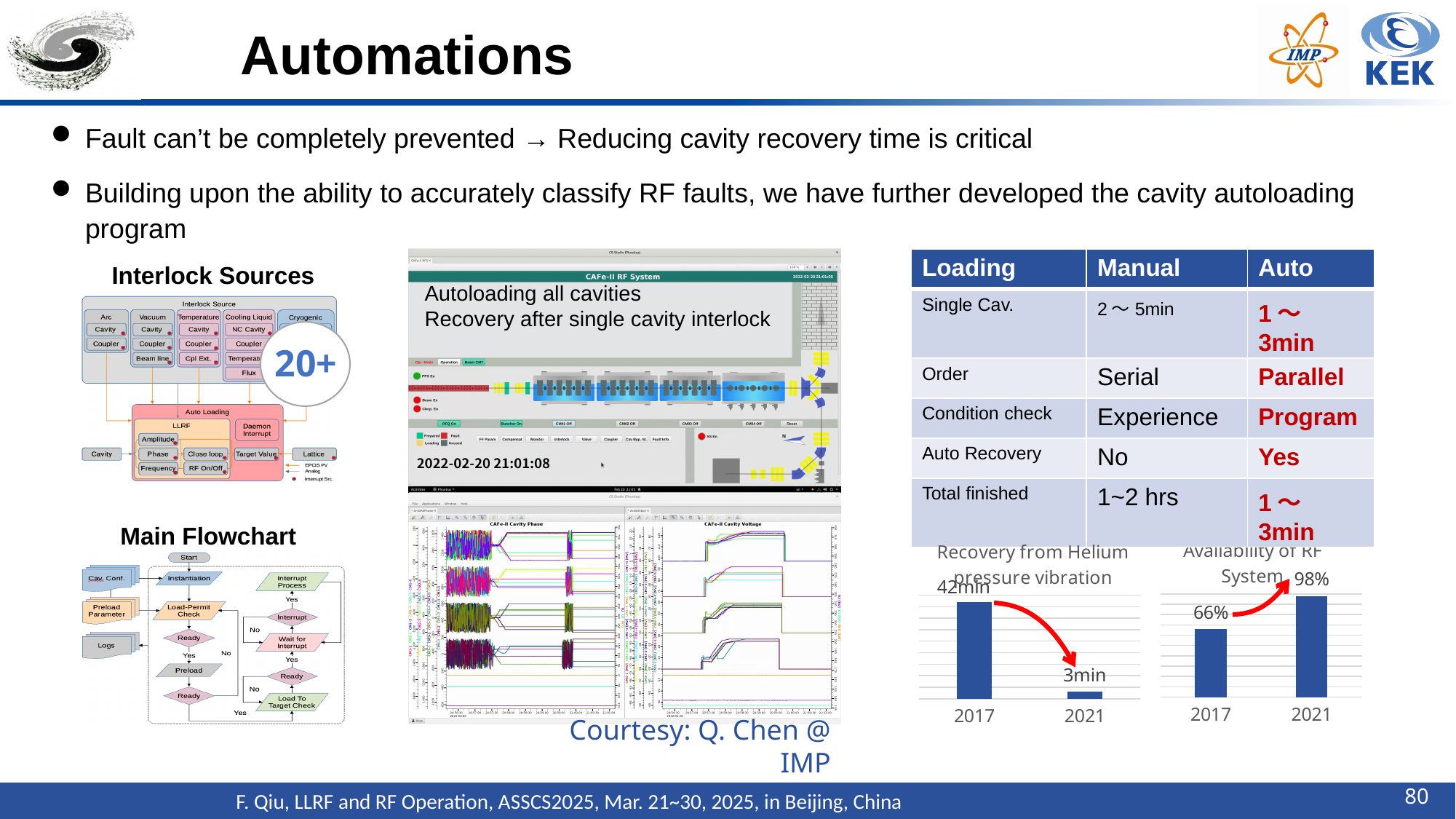
In the 'Availability of RF System' chart, is the value for 2021 larger than the value for 2017? Yes In the 'Recovery from Helium pressure vibration' chart, what is the value for 2017? 42min In the 'Availability of RF System' chart, by how much does the 2021 value exceed the 2017 value? 32% In the 'Recovery from Helium pressure vibration' chart, which year has the higher value? 2017 In the 'Availability of RF System' chart, what is the value for 2021? 98% In the 'Recovery from Helium pressure vibration' chart, do the values rise or fall from 2017 to 2021? Fall In the 'Recovery from Helium pressure vibration' chart, what is the value for 2021? 3min What kind of chart is the 'Availability of RF System' chart? Bar chart In the 'Availability of RF System' chart, which year has the lowest value? 2017 In the 'Availability of RF System' chart, what is the value for 2017? 66% In the 'Recovery from Helium pressure vibration' chart, what is the difference between the 2017 and 2021 values? 39min How many categories are shown in the 'Recovery from Helium pressure vibration' chart? 2